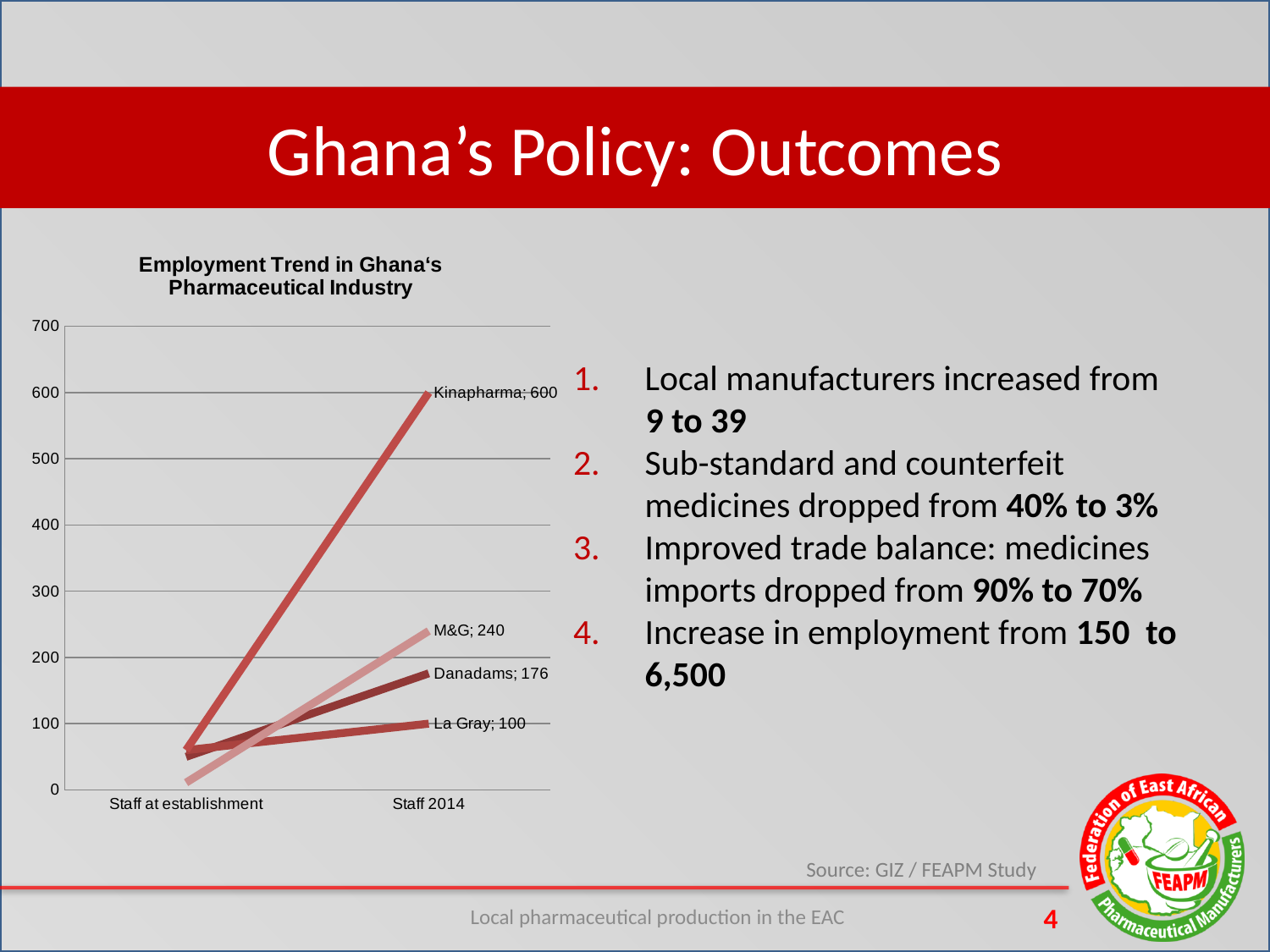
What is the difference between the Staff 2014 values for Kinapharma and M&G? 360 How many categories are shown on the x axis of the chart? 2 What is the Staff 2014 value for Danadams? 176 What is the Staff 2014 value for M&G? 240 Which has the larger Staff 2014 value, Danadams or La Gray? Danadams What kind of chart is used to show the employment trend? line chart In the Employment Trend in Ghana's Pharmaceutical Industry chart, what is the Staff 2014 value for Kinapharma? 600 What is the Staff 2014 value for La Gray? 100 Does the Kinapharma line rise or fall from Staff at establishment to Staff 2014? rise Which company has the highest Staff 2014 value? Kinapharma Which company has the lowest Staff 2014 value? La Gray Is the Staff at establishment value for M&G greater or less than 100? less